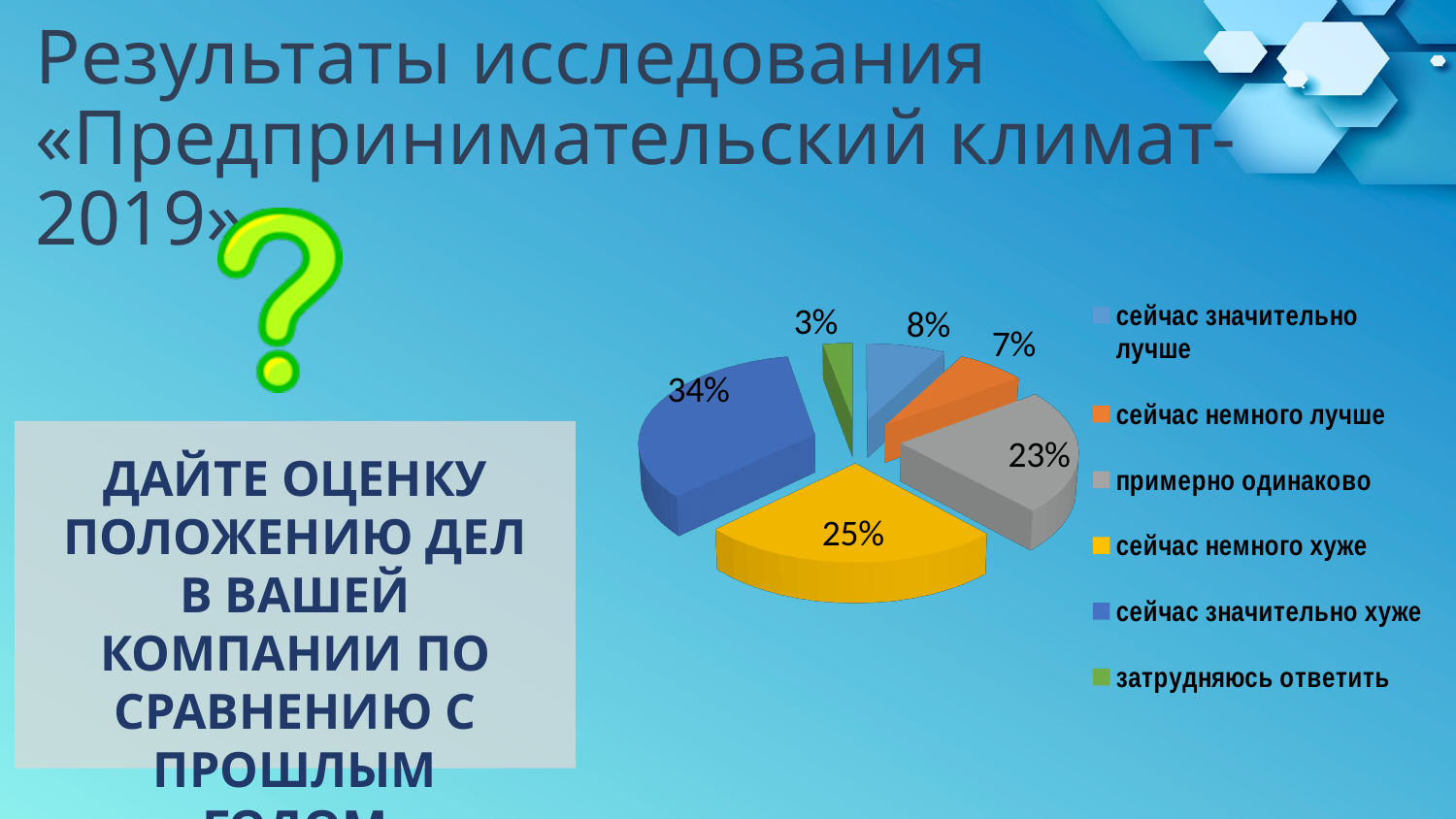
Which answer option has the smallest share of the pie? затрудняюсь ответить What share of respondents answered "примерно одинаково"? 23% What share of respondents answered "сейчас значительно хуже"? 34% What share of respondents answered "сейчас немного хуже"? 25% What share of respondents answered "сейчас значительно лучше"? 8% What colour is the slice for "сейчас немного хуже"? yellow How many slices does the pie chart have? 6 What kind of chart is shown on the slide? pie chart Which answer option has the largest share of the pie? сейчас значительно хуже Which is larger: the share for "сейчас значительно лучше" or for "сейчас немного лучше"? сейчас значительно лучше What share of respondents answered "затрудняюсь ответить"? 3% What is the difference between the shares for "сейчас значительно хуже" and "сейчас немного хуже"? 9%